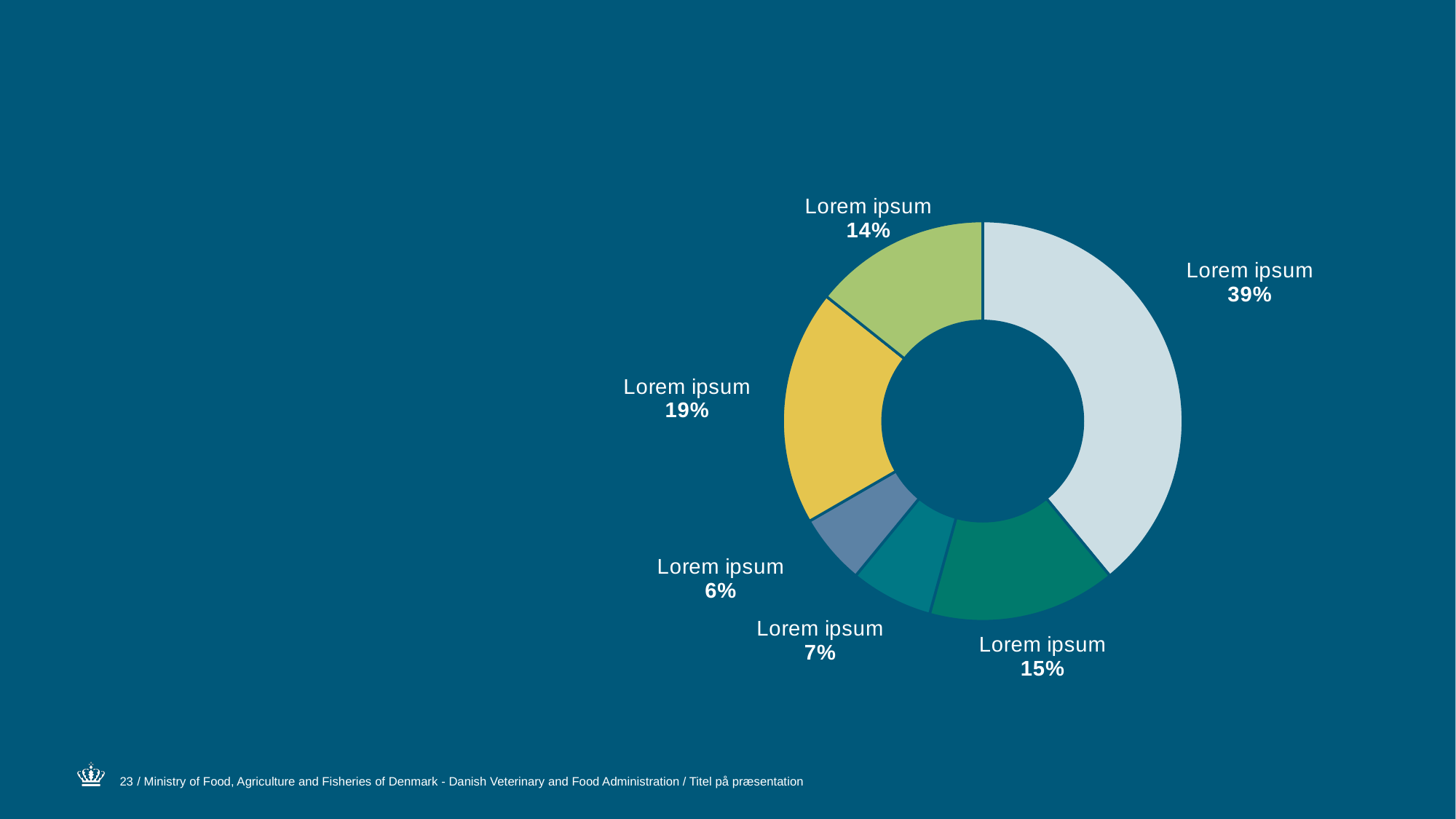
What kind of chart is shown on the slide? donut (pie) chart What percentage is shown for the light green slice at the top left of the donut chart? 14% What label text is shown for every slice of the donut chart? Lorem ipsum What is the largest percentage shown on the donut chart? 39% What is the smallest percentage shown on the donut chart? 6% What percentage is shown for the pale blue slice on the right side of the donut chart? 39% What percentage is shown for the yellow slice of the donut chart? 19% What is the difference in percentage points between the largest slice (39%) and the yellow slice (19%)? 20 percentage points Which slice is larger, the yellow slice or the light green slice? the yellow slice (19%) What is the difference in percentage points between the dark green slice (15%) and the teal slice (7%)? 8 percentage points What percentage is shown for the dark green slice at the bottom of the donut chart? 15% How many slices does the donut chart have? 6